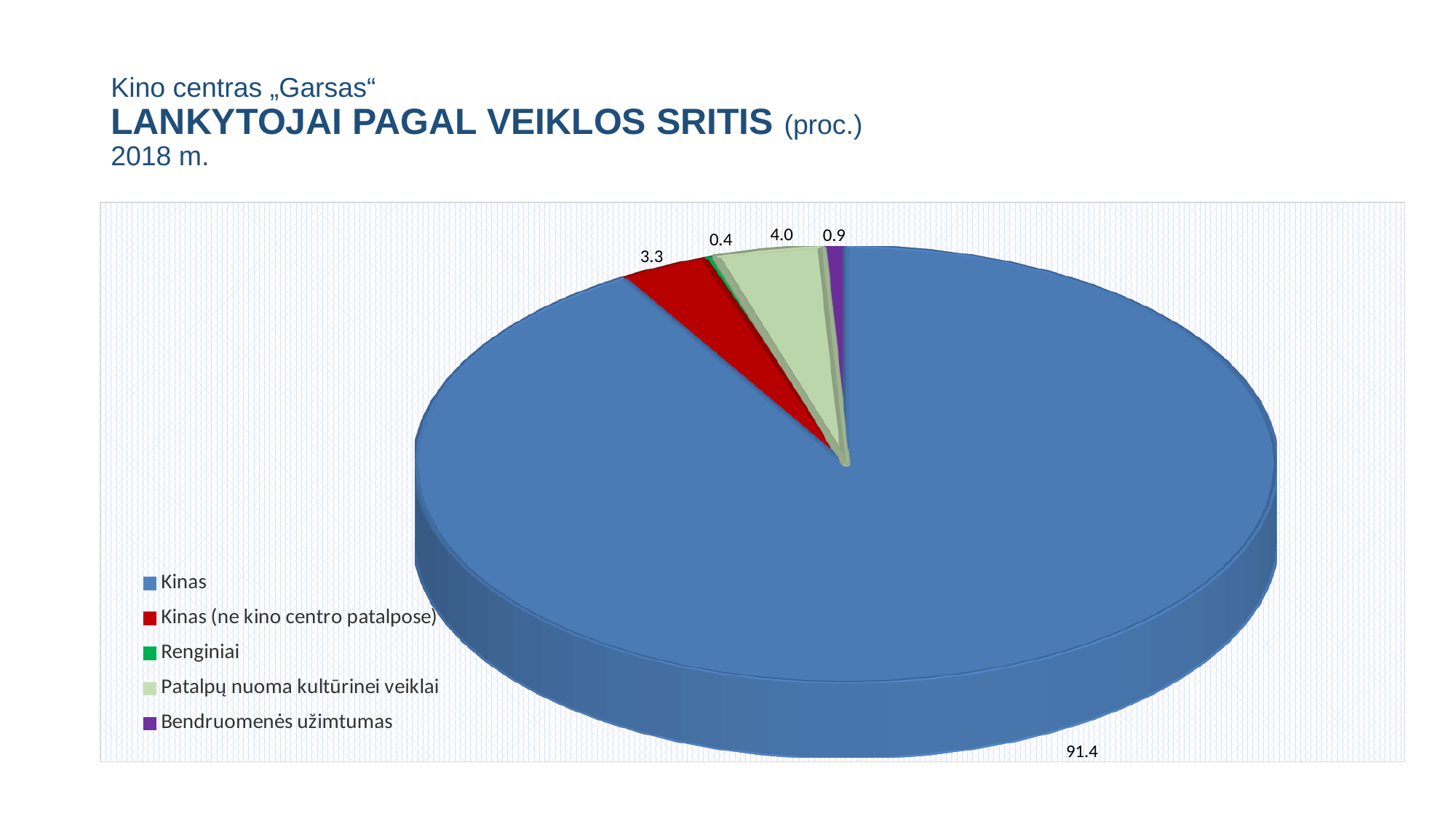
What is the value for Renginiai? 0.4 Which year does the chart title refer to? 2018 m. Which is larger, Patalpų nuoma kultūrinei veiklai or Kinas (ne kino centro patalpose)? Patalpų nuoma kultūrinei veiklai What is the value for Bendruomenės užimtumas? 0.9 Which category has the smallest share of the pie? Renginiai What is the value for Patalpų nuoma kultūrinei veiklai? 4.0 What is the difference between the values for Patalpų nuoma kultūrinei veiklai and Kinas (ne kino centro patalpose)? 0.7 What is the value for Kinas (ne kino centro patalpose)? 3.3 How many categories does the legend list? 5 What kind of chart is shown on the slide? Pie chart What is the value for Kinas? 91.4 Which category has the largest share of the pie? Kinas